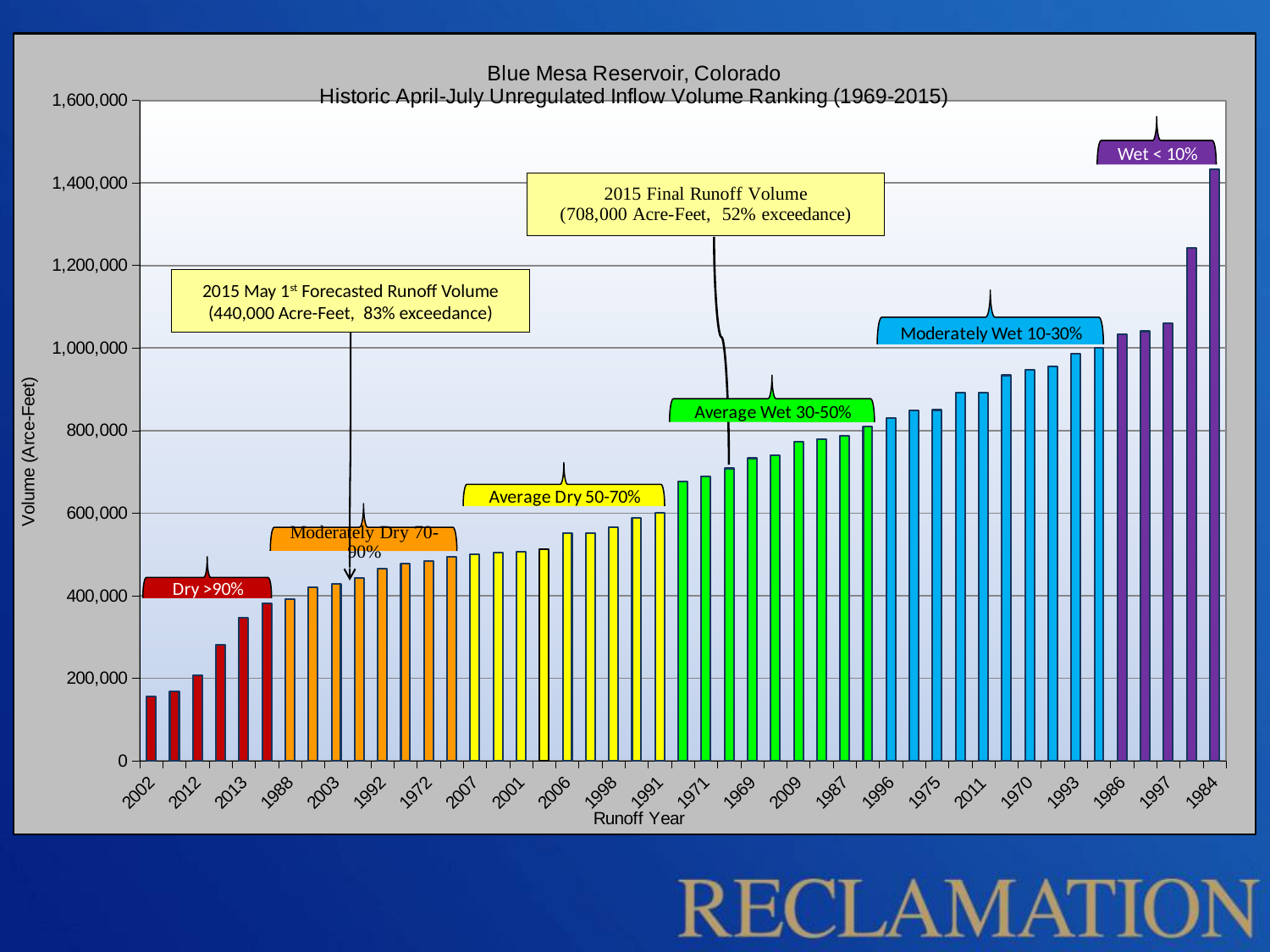
Is the inflow volume for 1984 greater or less than 1,200,000? greater By how much does the 2015 Final Runoff Volume exceed the 2015 May 1st Forecasted Runoff Volume? 268,000 Acre-Feet Which runoff year has the highest April-July unregulated inflow volume? 1984 Is the inflow volume for 2002 greater or less than 200,000? less What kind of chart is shown on the slide? Bar chart Is the inflow volume for 1969 greater or less than 800,000? less Which runoff year has the larger inflow volume, 1997 or 1988? 1997 Which runoff year has the lowest April-July unregulated inflow volume? 2002 What is the 2015 Final Runoff Volume shown in the callout? 708,000 Acre-Feet Do the bar values rise or fall moving from left to right along the x axis? Rise What is the 2015 May 1st Forecasted Runoff Volume shown in the callout? 440,000 Acre-Feet What exceedance percentage is given for the 2015 Final Runoff Volume? 52% exceedance